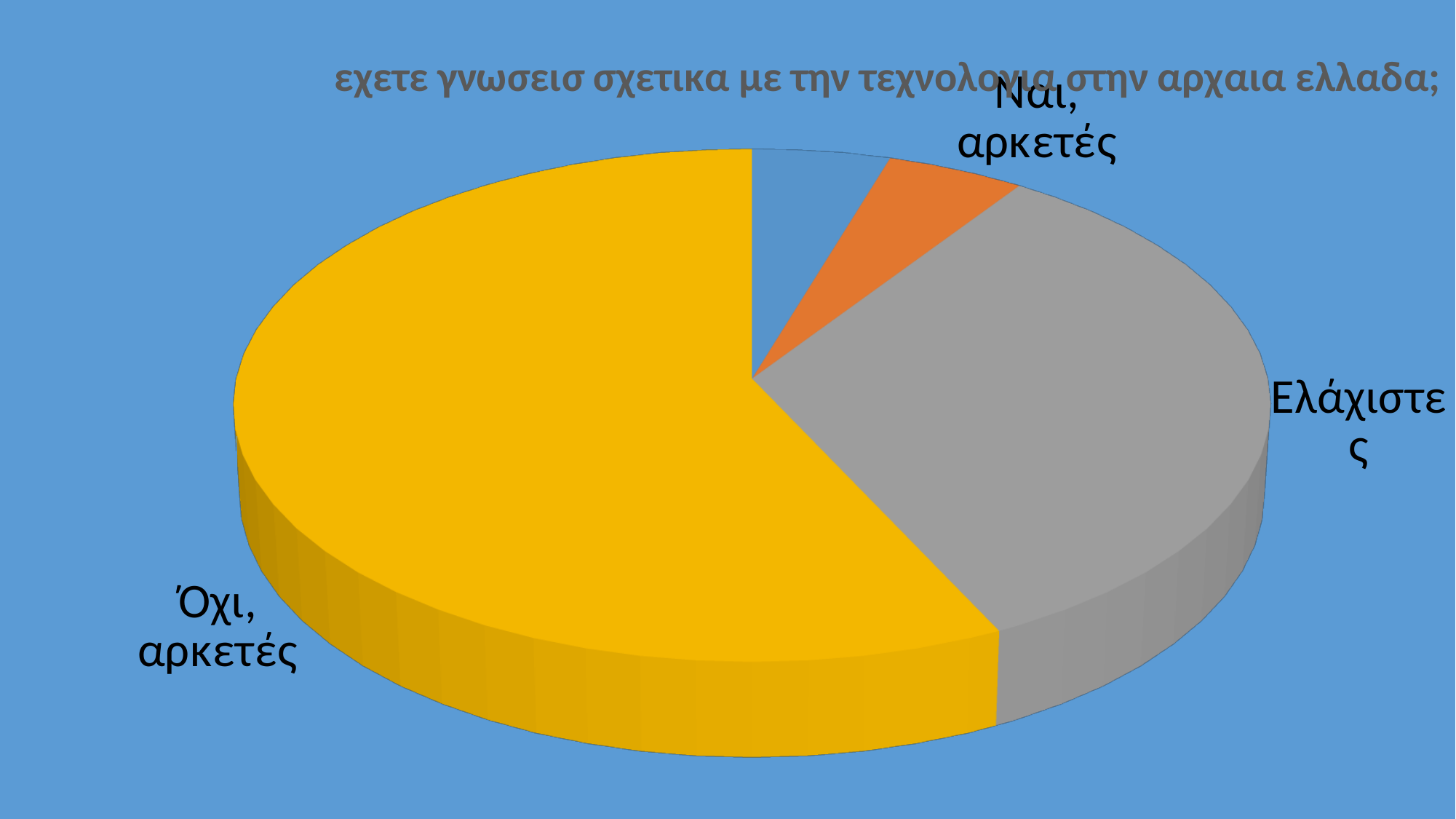
How many slices does the pie chart have? 4 Which category has the largest slice of the pie? Όχι, αρκετές What colour is the slice labelled "Όχι, αρκετές"? yellow What kind of chart is shown on the slide? pie chart Which slice is larger, "Ελάχιστες" or "Ναι, αρκετές"? Ελάχιστες What is the title of the chart? εχετε γνωσεισ σχετικα με την τεχνολογια στην αρχαια ελλαδα; Which slice is larger, "Όχι, αρκετές" or "Ελάχιστες"? Όχι, αρκετές